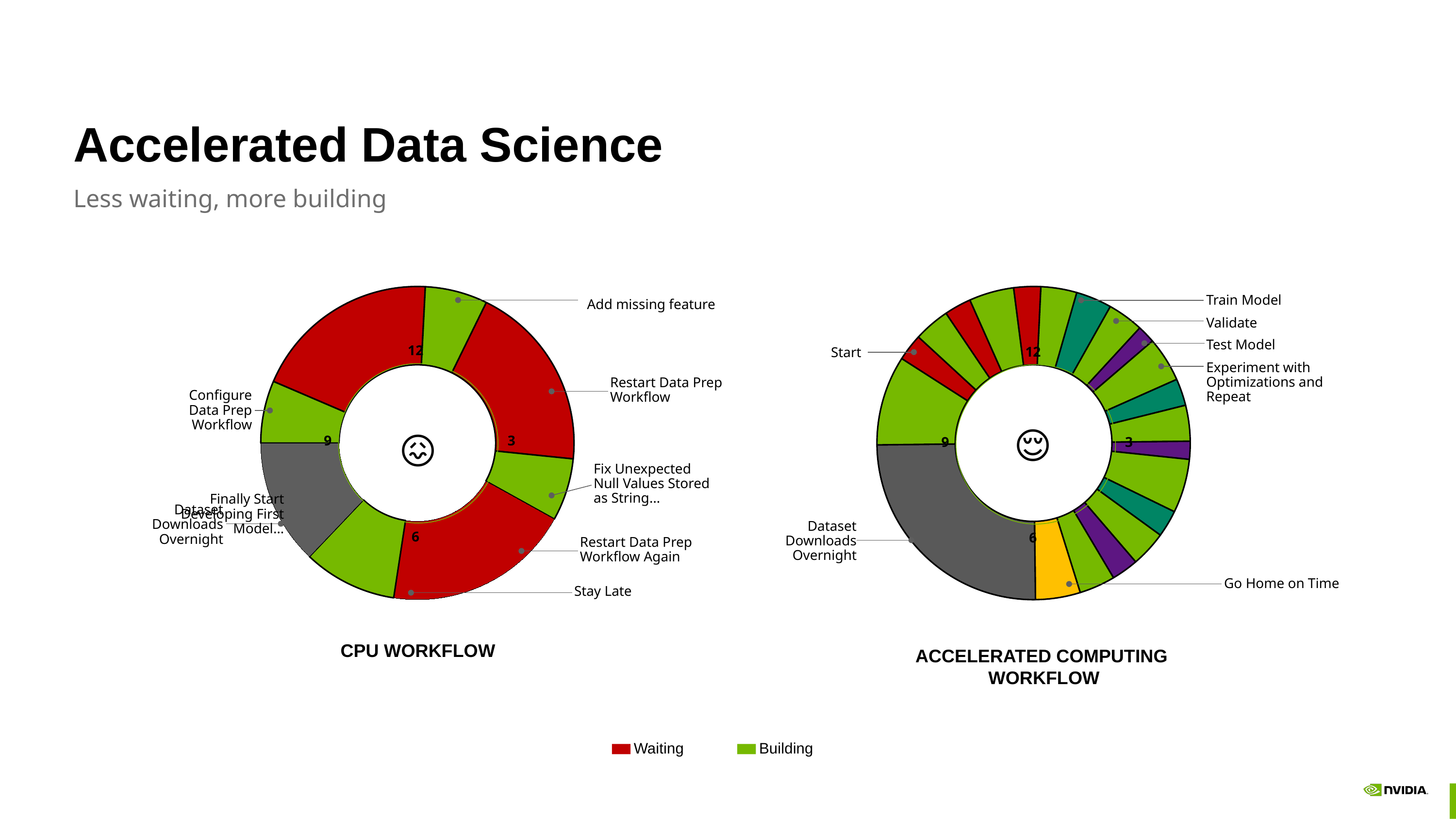
In the ACCELERATED COMPUTING WORKFLOW chart, which labelled slice is the largest? Dataset Downloads Overnight In the ACCELERATED COMPUTING WORKFLOW chart, which slice is larger: Dataset Downloads Overnight or Go Home on Time? Dataset Downloads Overnight In the CPU WORKFLOW chart, which slice is larger: Stay Late or Add missing feature? Stay Late In the CPU WORKFLOW chart, which slice is larger: Restart Data Prep Workflow or Fix Unexpected Null Values Stored as String...? Restart Data Prep Workflow Which colour represents Waiting in the legend? red How many entries does the legend at the bottom of the slide list? 2 What kind of chart is the CPU WORKFLOW chart? donut chart How many charts are shown on the slide? 2 What are the two legend entries shown on the slide? Waiting and Building How many slices does the CPU WORKFLOW donut chart have? 8